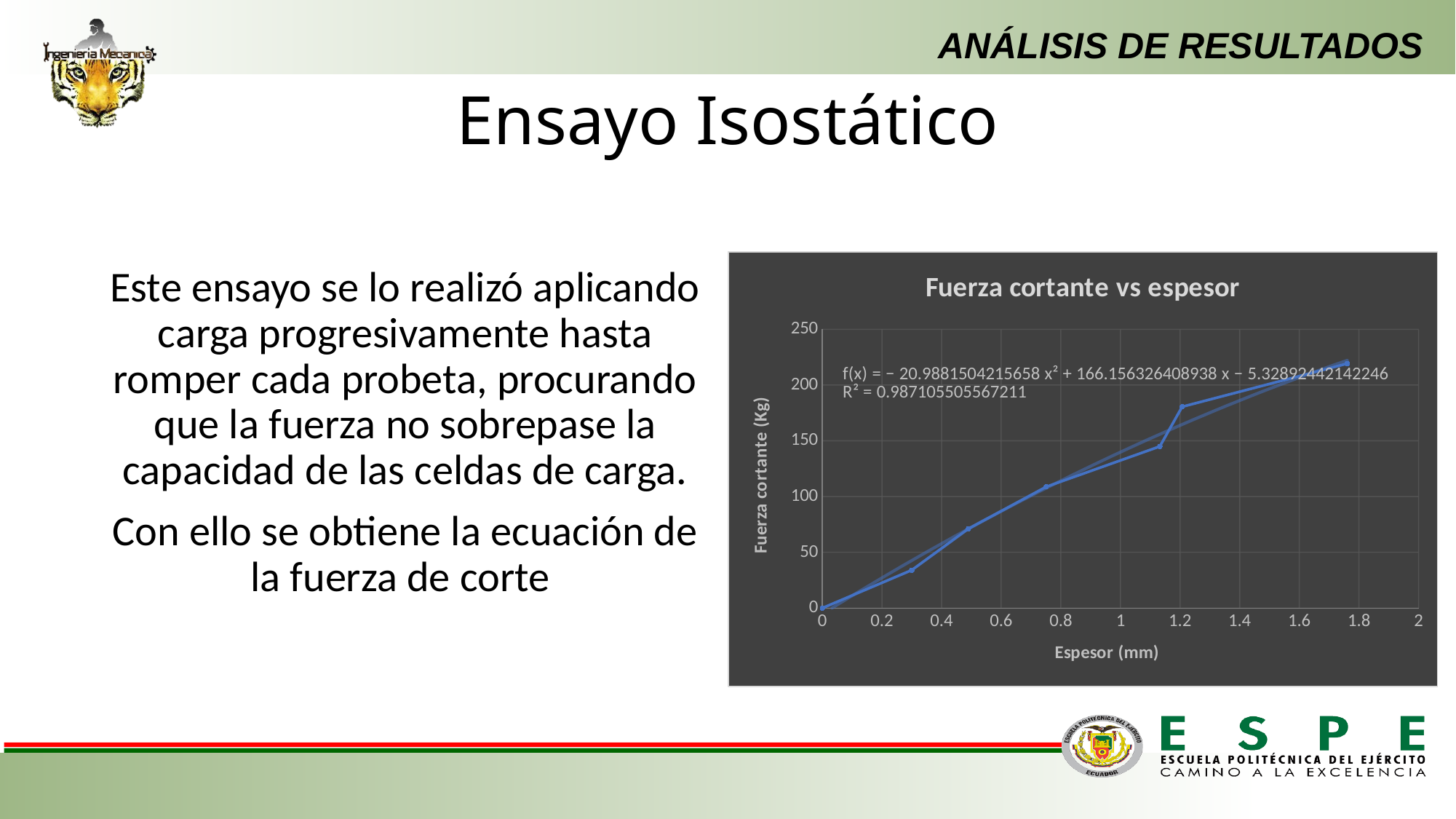
Is the highest plotted value on the chart greater or less than 200? greater How many data points are plotted on the chart? 7 Is the value for Espesor 0.5 mm greater or less than 50? greater Is the value for Espesor 0.3 mm greater or less than 50? less What is the maximum value shown on the y axis of the chart? 250 What is the maximum value shown on the x axis of the chart? 2 What is the title of the chart? Fuerza cortante vs espesor What kind of chart is shown on the slide? line chart What is the R² value printed on the chart? 0.987105505567211 Does the shear force rise or fall as the thickness (Espesor) increases along the x axis? rise What is the label of the y axis of the chart? Fuerza cortante (Kg)